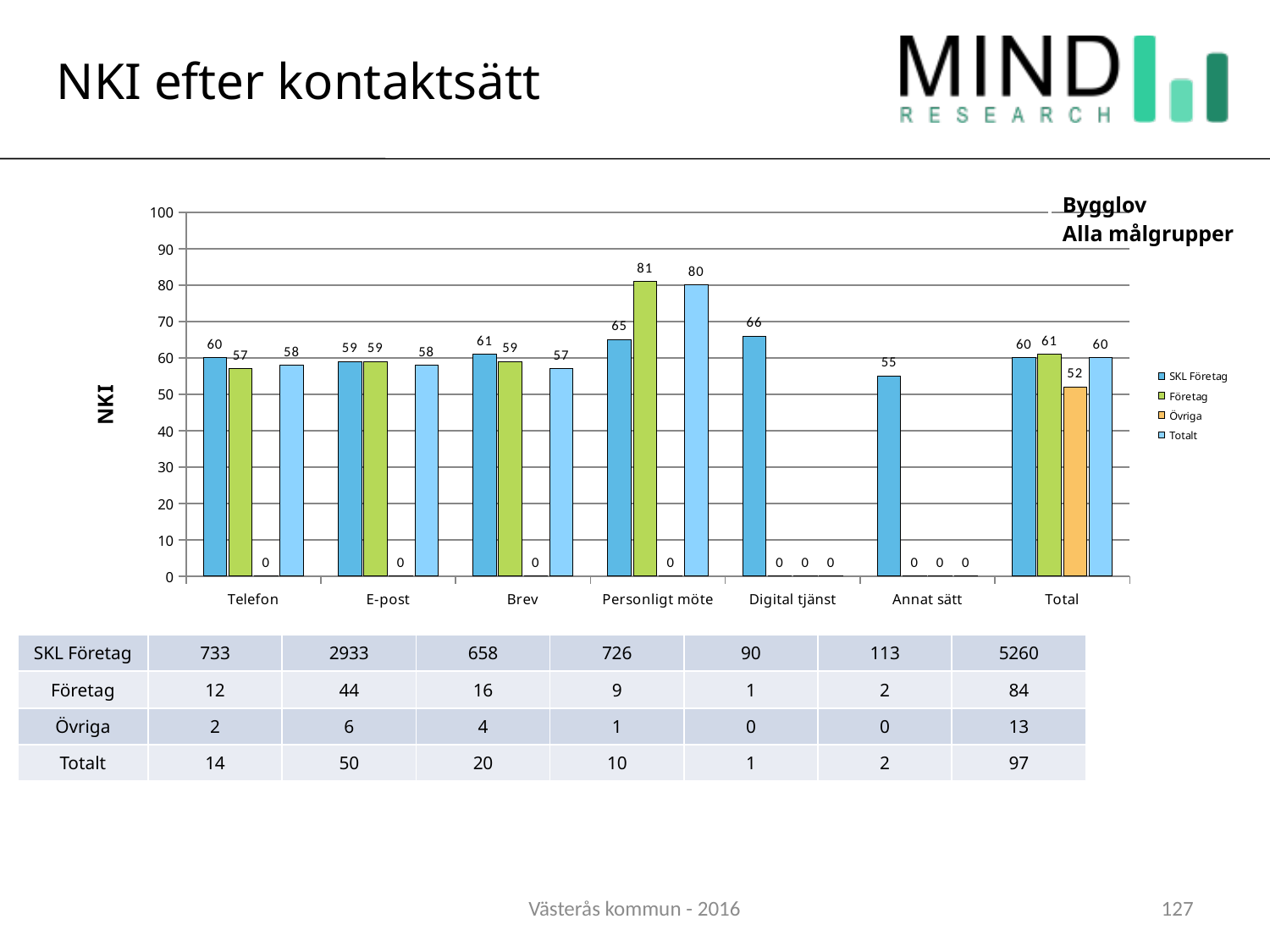
Which contact method has the highest Totalt value? Personligt möte How many contact method categories are shown on the x axis? 7 What kind of chart is shown on the slide? Bar chart What is the NKI value for Övriga in the Total category? 52 How many series does the legend list? 4 What is the difference between the Företag and SKL Företag values for Personligt möte? 16 What is the Totalt value for Brev? 57 What is the NKI value for SKL Företag for Digital tjänst? 66 What is the NKI value for Företag for Personligt möte? 81 Which contact method has the lowest SKL Företag value? Annat sätt What is the label on the vertical axis of the chart? NKI Which is larger: the SKL Företag value for Telefon or the SKL Företag value for Annat sätt? Telefon